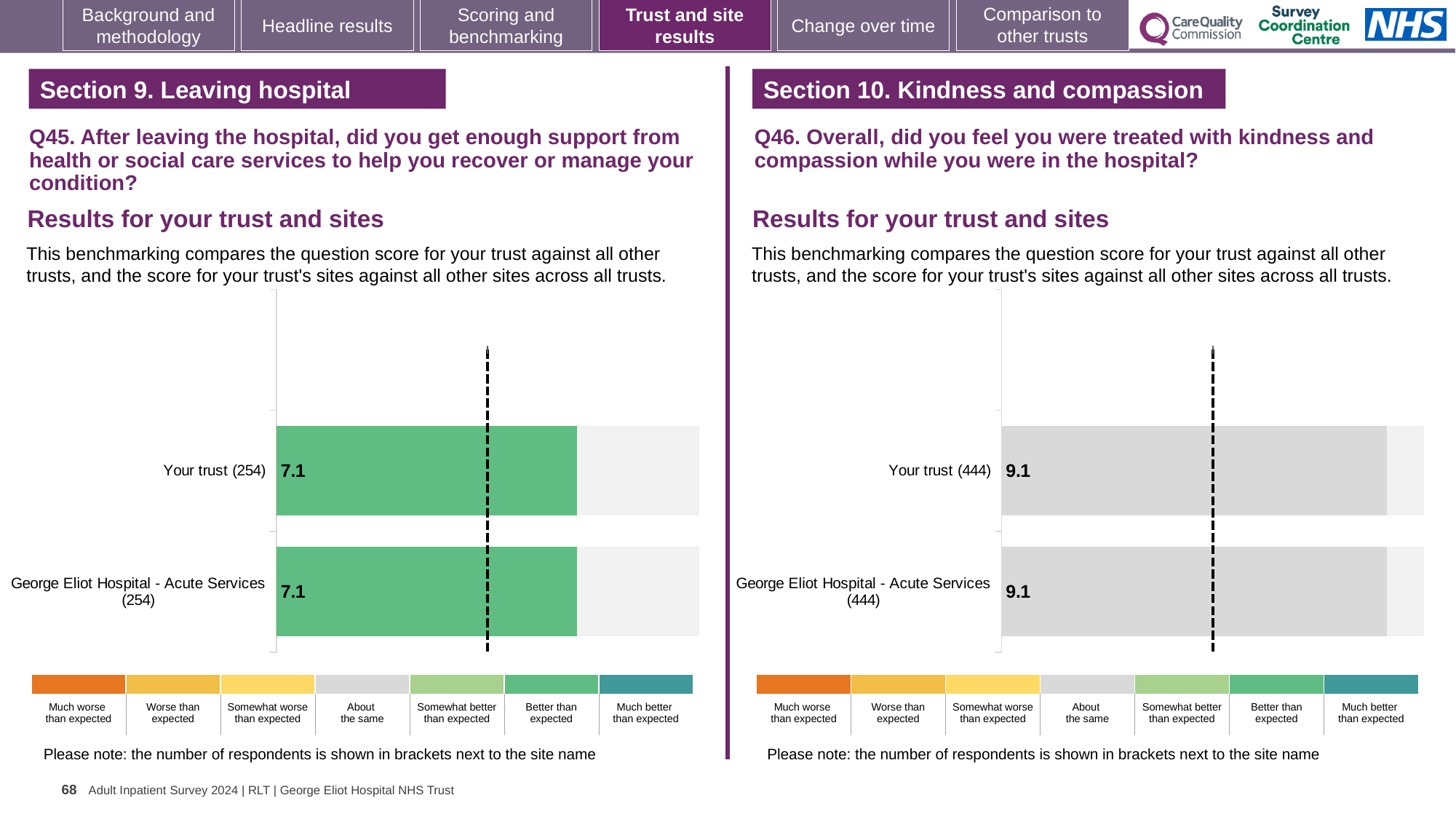
On the Q46 chart (right), what is the score for George Eliot Hospital - Acute Services? 9.1 On the Q45 chart (left), what is the score for Your trust? 7.1 How many bars are plotted on the Q46 chart (right)? 2 On the Q45 chart (left), what is the difference between the score for Your trust and the score for George Eliot Hospital - Acute Services? 0 On the Q45 chart (left), how many respondents are shown in brackets for Your trust? 254 According to the colour key, which benchmarking category does the green colour of the bars on the Q45 chart (left) represent? Better than expected On the Q46 chart (right), what is the difference between the score for Your trust and the score for George Eliot Hospital - Acute Services? 0 On the Q46 chart (right), what is the score for Your trust? 9.1 On the Q46 chart (right), how many respondents are shown in brackets for George Eliot Hospital - Acute Services? 444 What kind of chart is used for the Q45 results on the left? Bar chart On the Q45 chart (left), what is the score for George Eliot Hospital - Acute Services? 7.1 How many bars are plotted on the Q45 chart (left)? 2